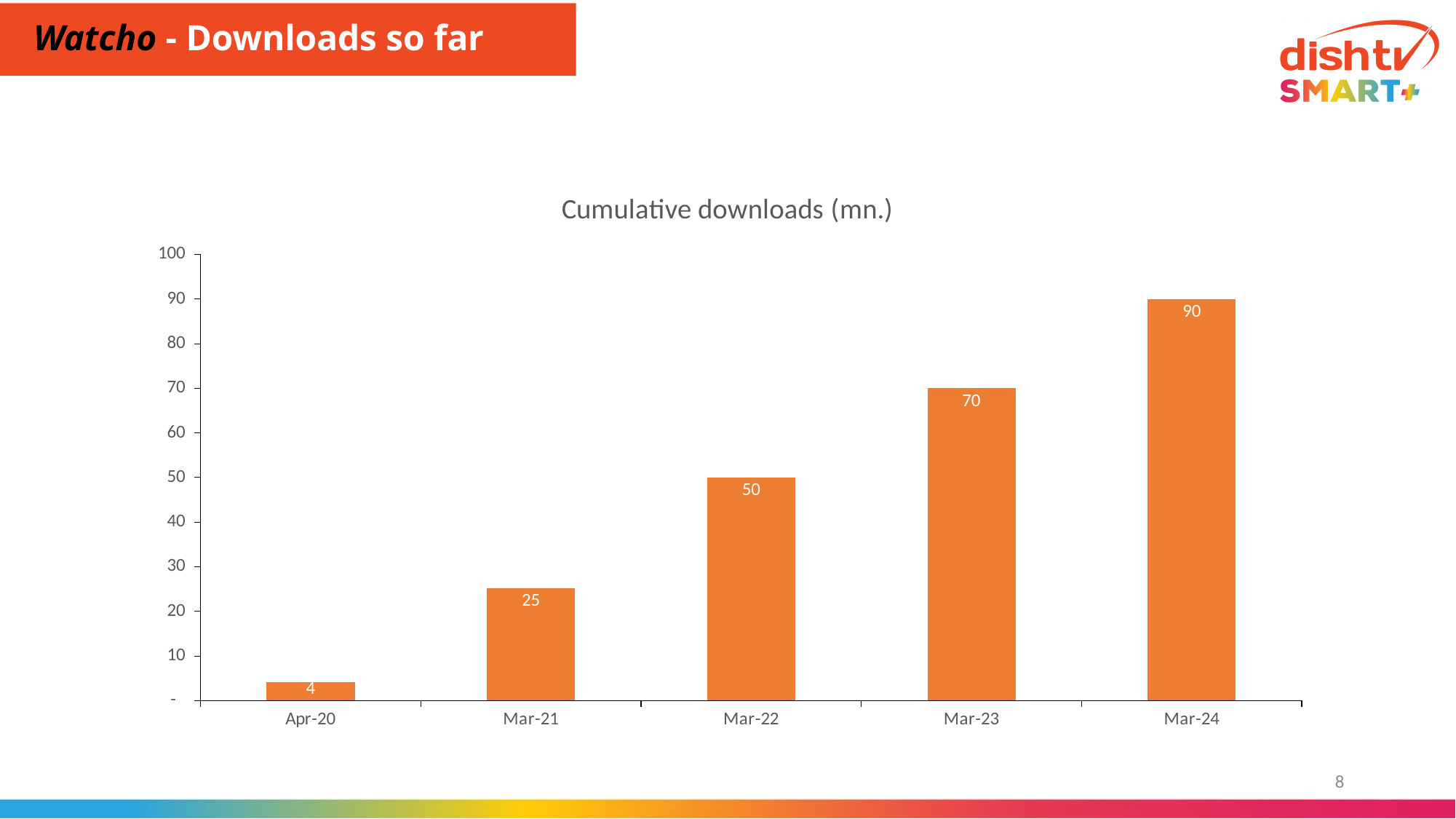
What is the difference in cumulative downloads between Mar-22 and Mar-21? 25 What is the cumulative downloads value for Mar-22? 50 Is the value for Mar-23 greater or less than 60? greater Which period has the highest cumulative downloads? Mar-24 What kind of chart is shown on the slide? Bar chart Do cumulative downloads rise or fall from Apr-20 to Mar-24? Rise Which has higher cumulative downloads, Mar-21 or Mar-23? Mar-23 Which period has the lowest cumulative downloads? Apr-20 What is the cumulative downloads value for Apr-20? 4 What is the cumulative downloads value for Mar-24? 90 What is the difference in cumulative downloads between Mar-24 and Mar-23? 20 How many periods are shown on the x axis of the chart? 5